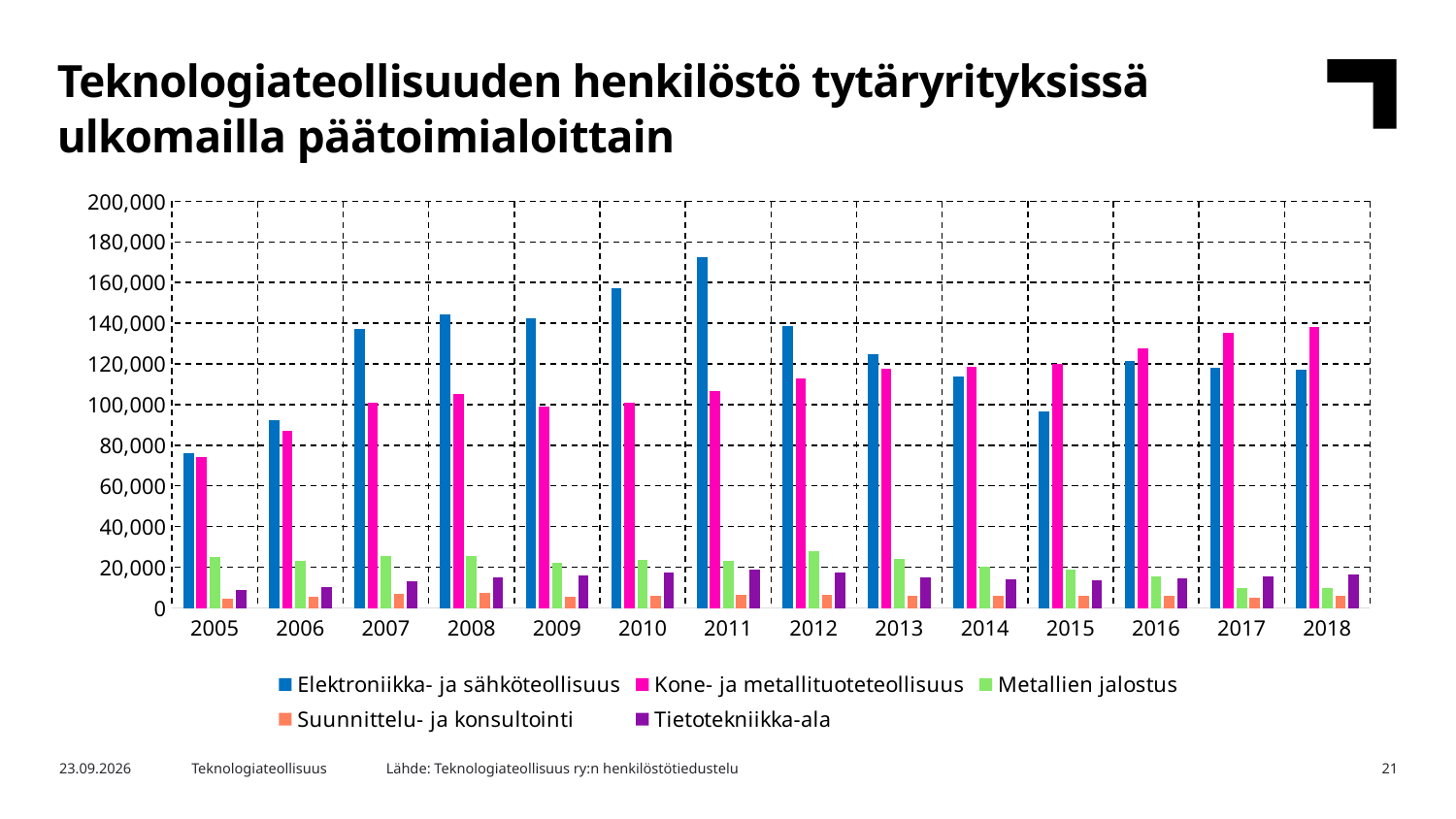
In which year is the value for Elektroniikka- ja sähköteollisuus highest? 2011 What kind of chart is shown on the slide? Bar chart In 2011, which is larger: Elektroniikka- ja sähköteollisuus or Kone- ja metallituoteteollisuus? Elektroniikka- ja sähköteollisuus What is the title of the chart on the slide? Teknologiateollisuuden henkilöstö tytäryrityksissä ulkomailla päätoimialoittain Does the value for Kone- ja metallituoteteollisuus rise or fall from 2013 to 2018? Rise Is the value for Kone- ja metallituoteteollisuus in 2018 greater or less than 120,000? greater Is the value for Elektroniikka- ja sähköteollisuus in 2011 greater or less than 160,000? greater How many years are shown on the x axis? 14 Is the value for Elektroniikka- ja sähköteollisuus in 2015 greater or less than 100,000? less In which year is the value for Elektroniikka- ja sähköteollisuus lowest? 2005 How many series does the legend list? 5 In 2018, which is larger: Elektroniikka- ja sähköteollisuus or Kone- ja metallituoteteollisuus? Kone- ja metallituoteteollisuus